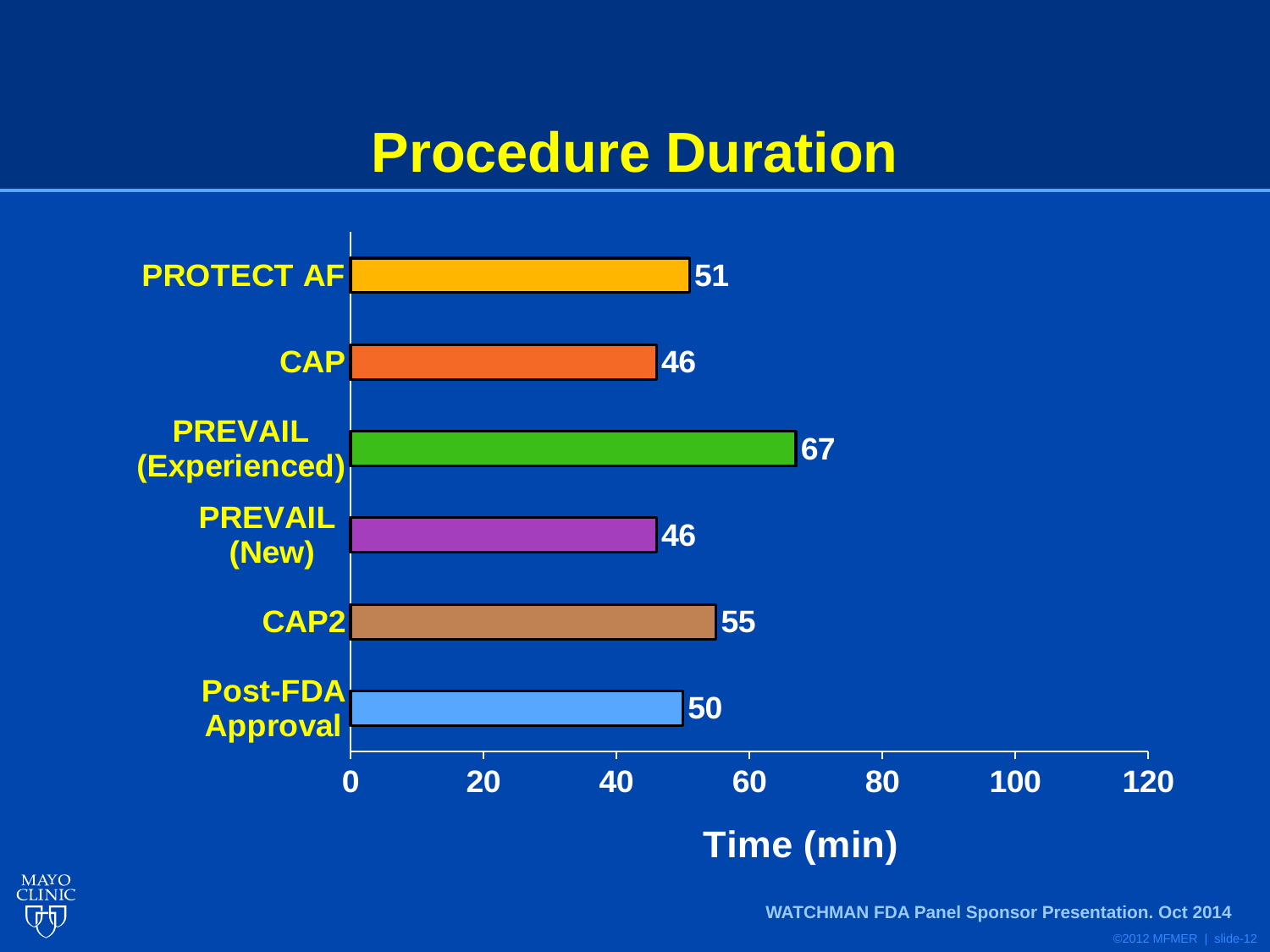
What is the difference in procedure duration between CAP2 and PROTECT AF? 4 Is the value for PREVAIL (Experienced) greater or less than 60? greater What is the label of the x axis? Time (min) What kind of chart is shown on the slide? Bar chart What is the procedure duration for PROTECT AF? 51 What is the difference in procedure duration between PREVAIL (Experienced) and PREVAIL (New)? 21 What is the procedure duration for CAP2? 55 What is the procedure duration for PREVAIL (Experienced)? 67 What is the procedure duration for Post-FDA Approval? 50 Which has a longer procedure duration, CAP2 or Post-FDA Approval? CAP2 Which category has the longest procedure duration? PREVAIL (Experienced) How many categories are shown in the chart? 6